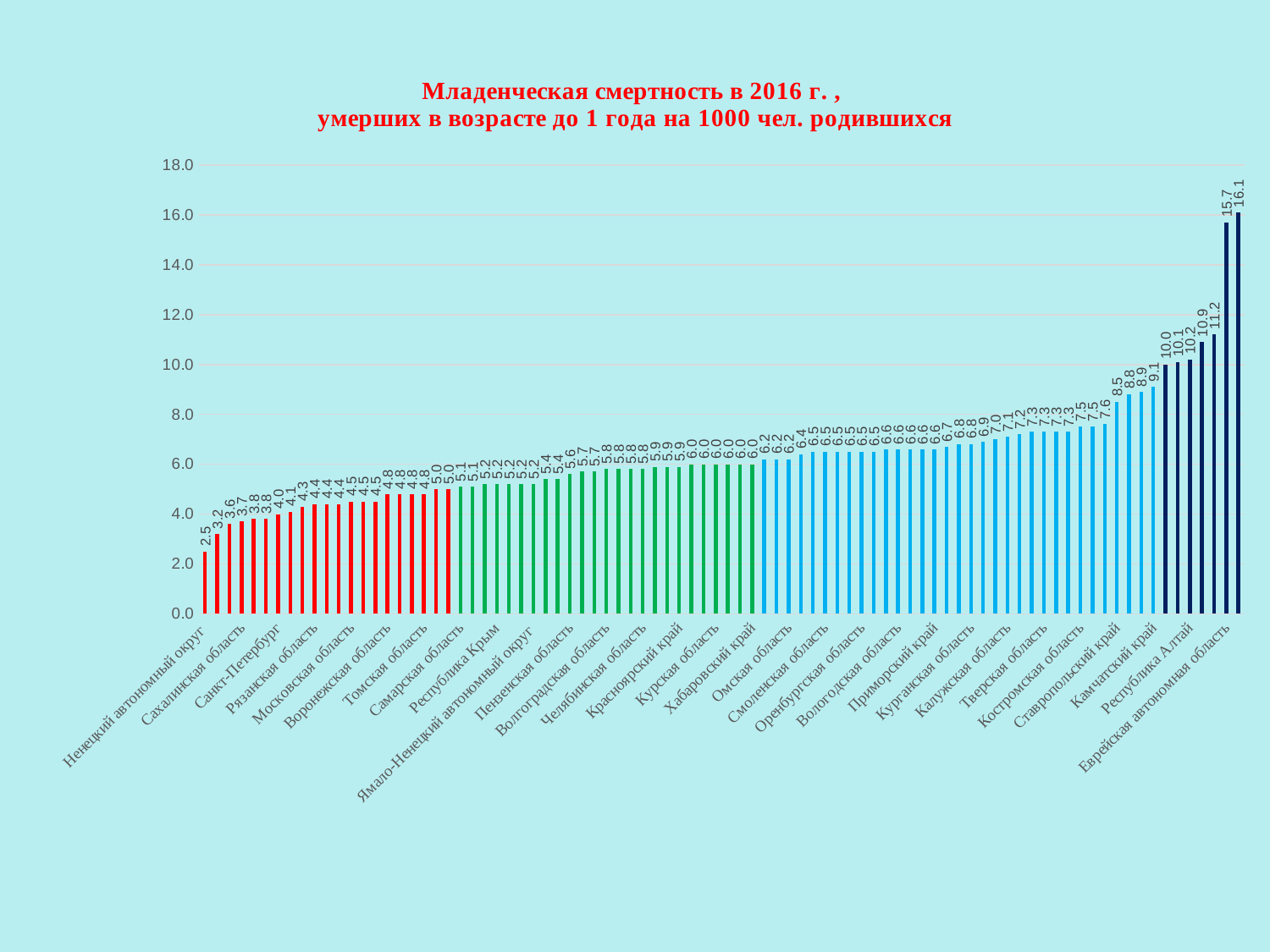
What is the difference between the highest value (16.1) and the lowest value (2.5) on the chart? 13.6 What is the value for Ненецкий автономный округ? 2.5 Do the bar values rise or fall from left to right along the x axis? rise Which region has the lowest infant mortality value on the chart? Ненецкий автономный округ Is the value for Ненецкий автономный округ greater or less than 4.0? less What is the value for Еврейская автономная область? 15.7 How many different bar colours are used in the chart? 4 What year does the chart title say the infant mortality data is for? 2016 Which is larger, the value for Еврейская автономная область or the value for Ненецкий автономный округ? Еврейская автономная область Is the value for Еврейская автономная область greater or less than 14.0? greater What kind of chart is shown on the slide? bar chart